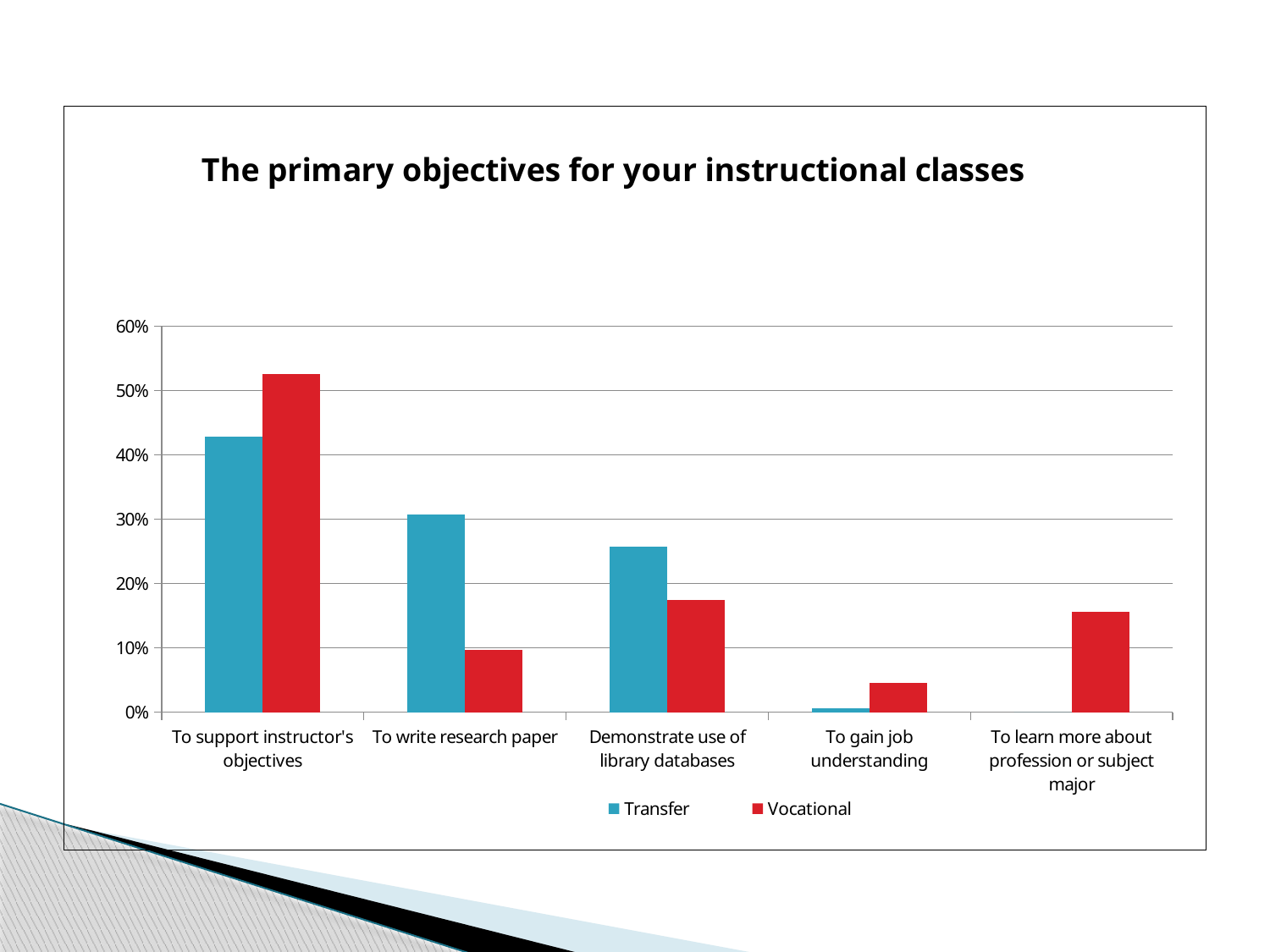
How many series does the legend list? 2 What is the title of the chart? The primary objectives for your instructional classes What kind of chart is shown on the slide? bar chart Is the Vocational value for To support instructor's objectives greater or less than 50%? greater Which category has the lowest Vocational value? To gain job understanding How many categories are shown on the x axis? 5 For To learn more about profession or subject major, which series has the larger value, Transfer or Vocational? Vocational For Demonstrate use of library databases, which series has the larger value, Transfer or Vocational? Transfer Which category has the highest Transfer value? To support instructor's objectives Which category has the highest Vocational value? To support instructor's objectives Is the Vocational value for To write research paper greater or less than 20%? less